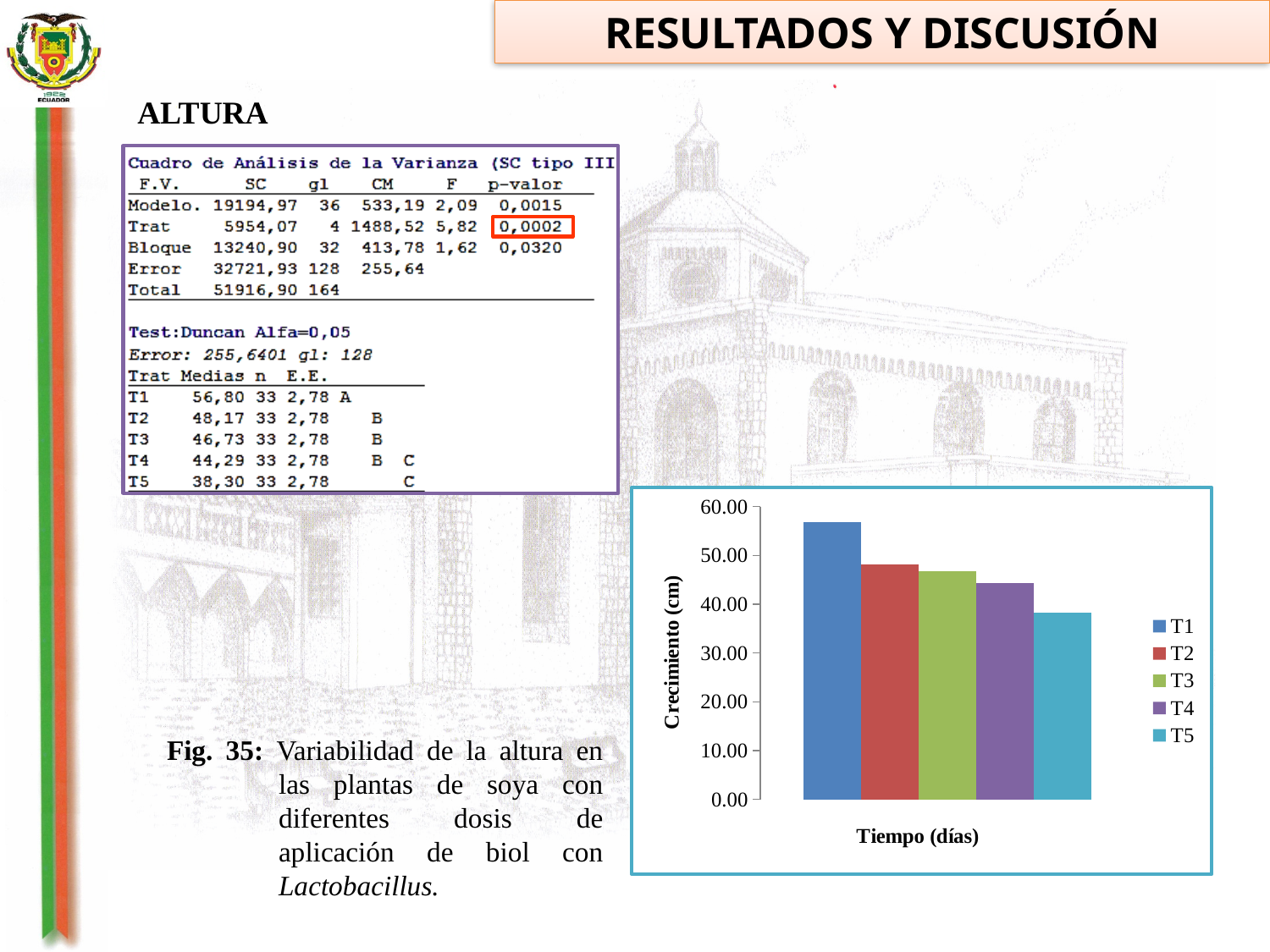
Is the value for T2 greater or less than 50.00? less What kind of chart is shown on the slide? bar chart Is the value for T5 greater or less than 40.00? less How many series does the chart legend list? 5 Which series has the tallest bar in the chart? T1 Which is larger, the value for T1 or the value for T5? T1 Do the bar heights rise or fall from T1 to T5? fall Is the value for T1 greater or less than 50.00? greater Which series has the shortest bar in the chart? T5 How many bars are plotted in the chart? 5 What is the label of the vertical axis of the chart? Crecimiento (cm)